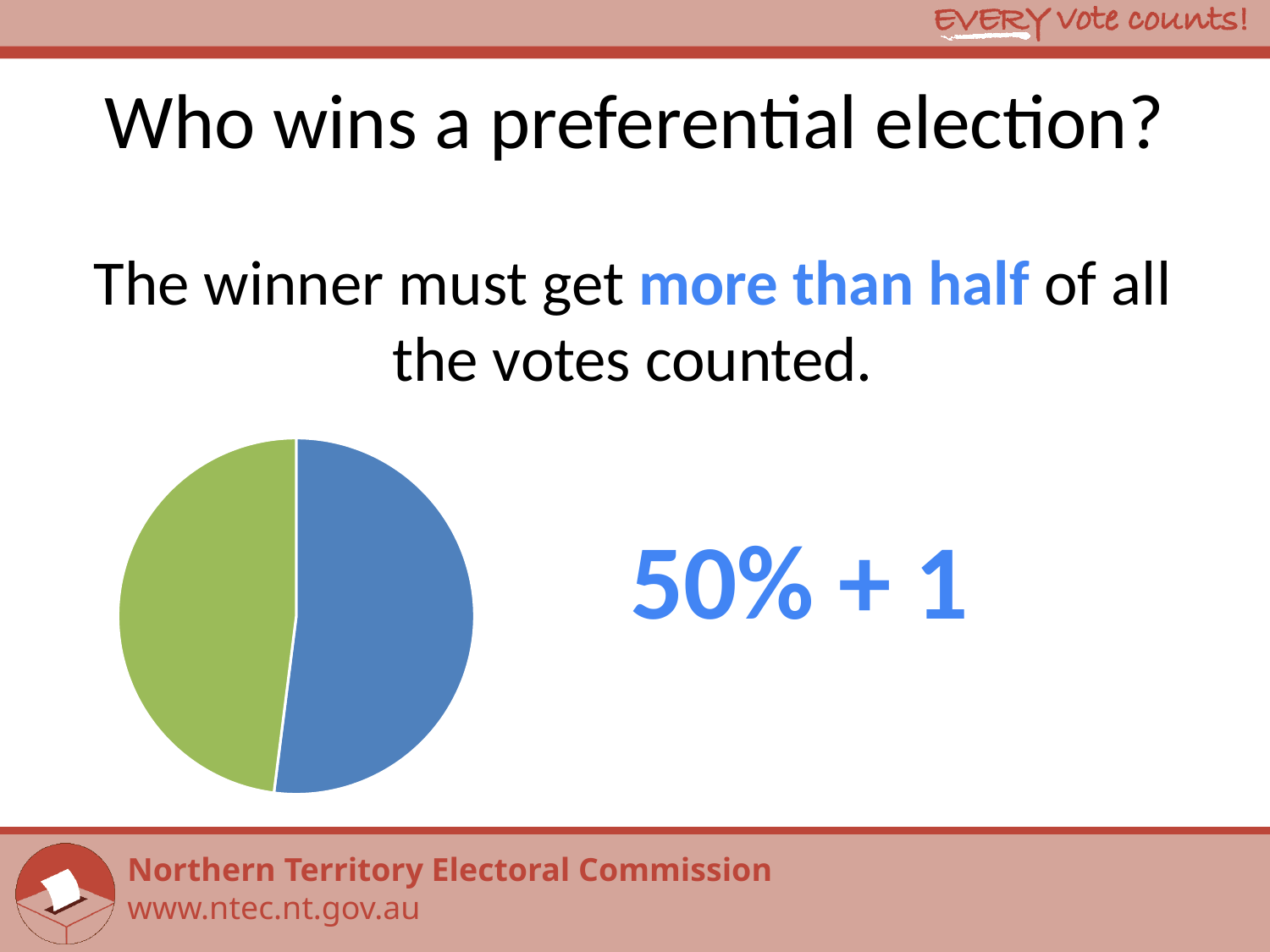
How many slices does the pie chart have? 2 What kind of chart is shown on the slide? pie chart Which slice of the pie chart is larger, the blue one or the green one? blue Does the pie chart have a legend? No Does the pie chart show any data labels on its slices? No What colours are the two slices of the pie chart? blue and green